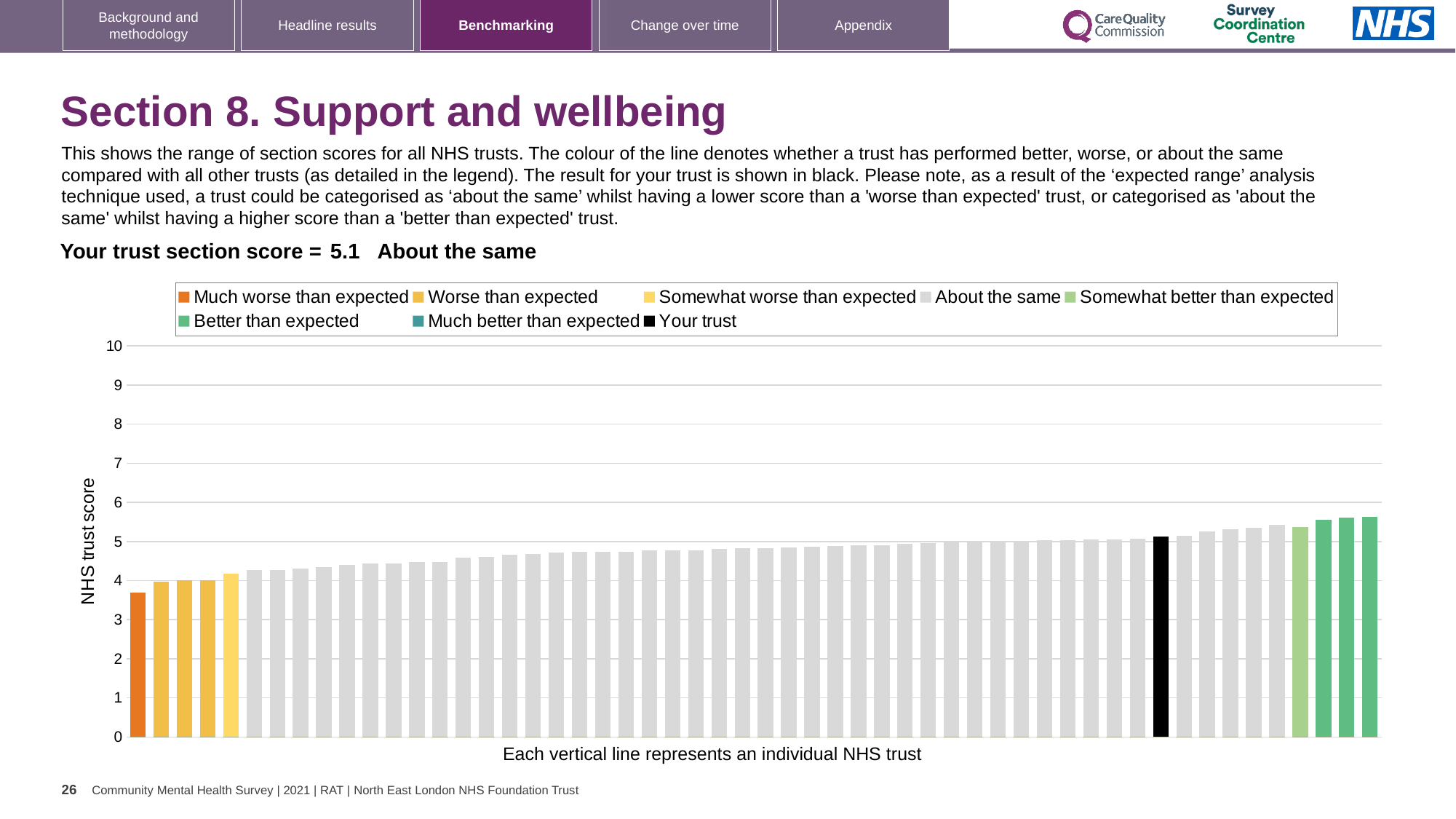
What kind of chart is shown on the slide? bar chart What is the label on the vertical axis of the chart? NHS trust score Which benchmarking category is your trust placed in for Section 8? About the same Is the value of the black bar (your trust) greater or less than 4? greater What is the section score for your trust shown on the slide? 5.1 Which legend category do the highest bars on the chart belong to? Better than expected Do the bar values rise or fall from left to right along the x axis? rise How many entries does the chart legend list? 8 Is the value of the lowest bar (orange, much worse than expected) greater or less than 4? less Is the value of the highest bar greater or less than 6? less Which legend category does the lowest bar on the chart belong to? Much worse than expected How many bars are coloured as 'Much worse than expected' (orange)? 1